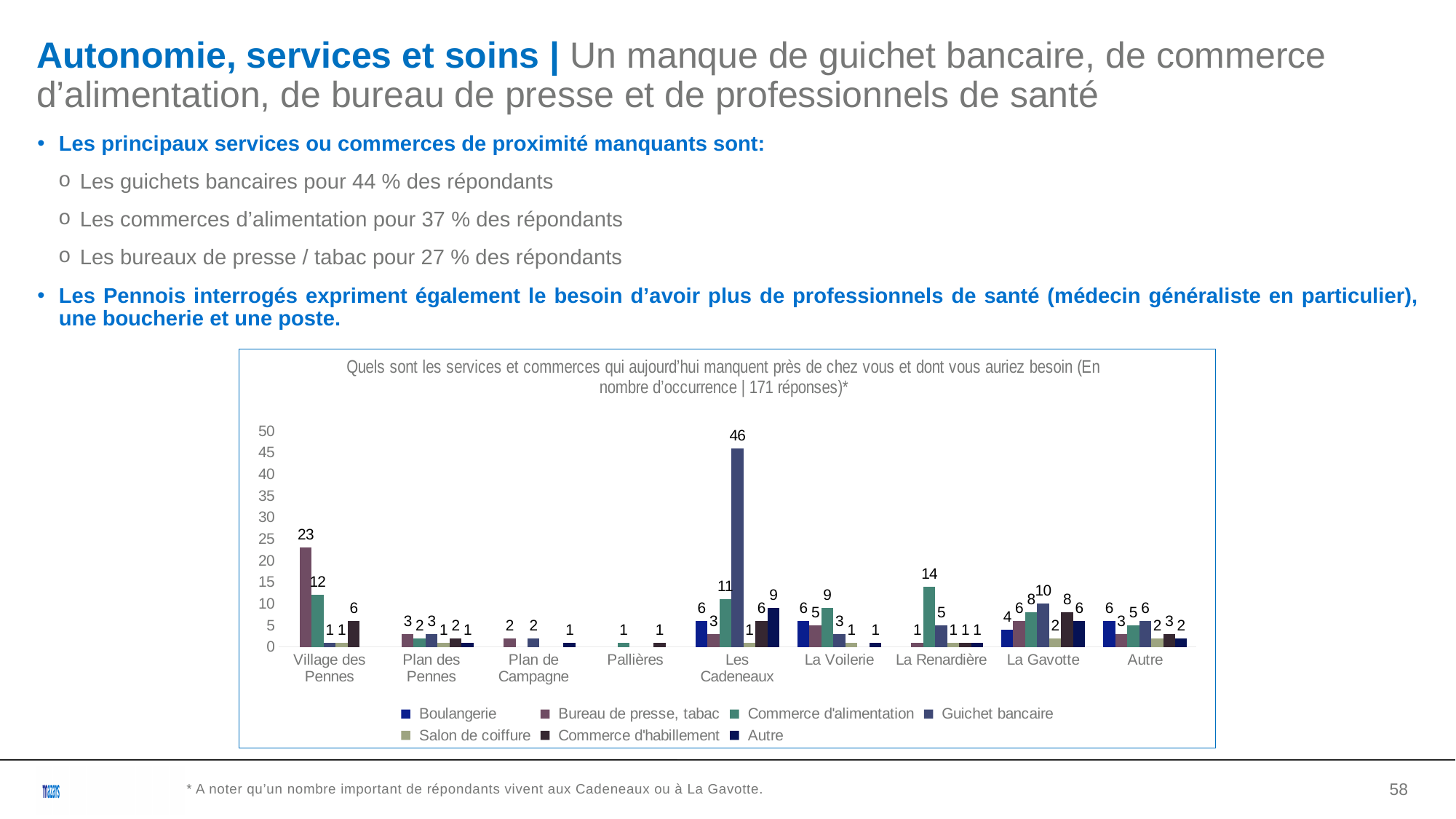
How many locations are shown on the x axis? 9 Is the value for Guichet bancaire at Les Cadeneaux greater or less than 40? greater What is the value for Bureau de presse, tabac at Village des Pennes? 23 Which location has the highest value for Guichet bancaire? Les Cadeneaux What is the value for Guichet bancaire at Les Cadeneaux? 46 Which location has the highest value for Commerce d'alimentation? La Renardière How many series does the legend list? 7 Which is larger: Commerce d'alimentation at Les Cadeneaux or Commerce d'alimentation at La Voilerie? Les Cadeneaux What kind of chart is shown on the slide? bar chart What is the value for Commerce d'alimentation at La Renardière? 14 What is the difference between the Guichet bancaire values at Les Cadeneaux and La Gavotte? 36 How many responses does the chart title say the data is based on? 171